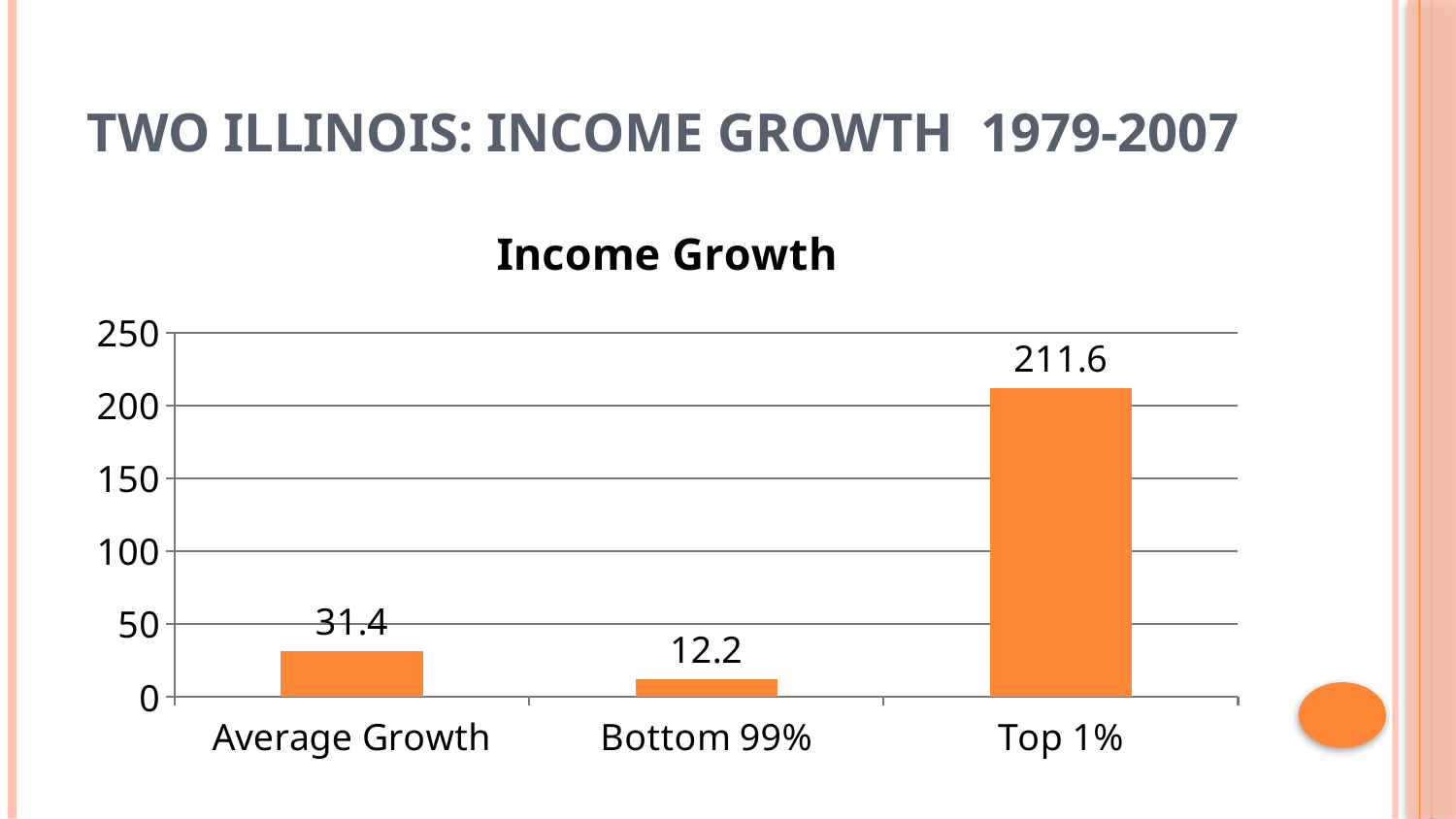
What is the value for Average Growth? 31.4 What is the value for Bottom 99%? 12.2 Which category has the highest value? Top 1% Which is larger, the value for Average Growth or the value for Bottom 99%? Average Growth What is the difference between the values for Average Growth and Bottom 99%? 19.2 What is the value for Top 1%? 211.6 What is the title of the chart? Income Growth What is the difference between the values for Top 1% and Bottom 99%? 199.4 Which category has the lowest value? Bottom 99% What kind of chart is shown on the slide? bar chart How many categories are shown on the x axis? 3 Is the value for Top 1% greater or less than 200? greater